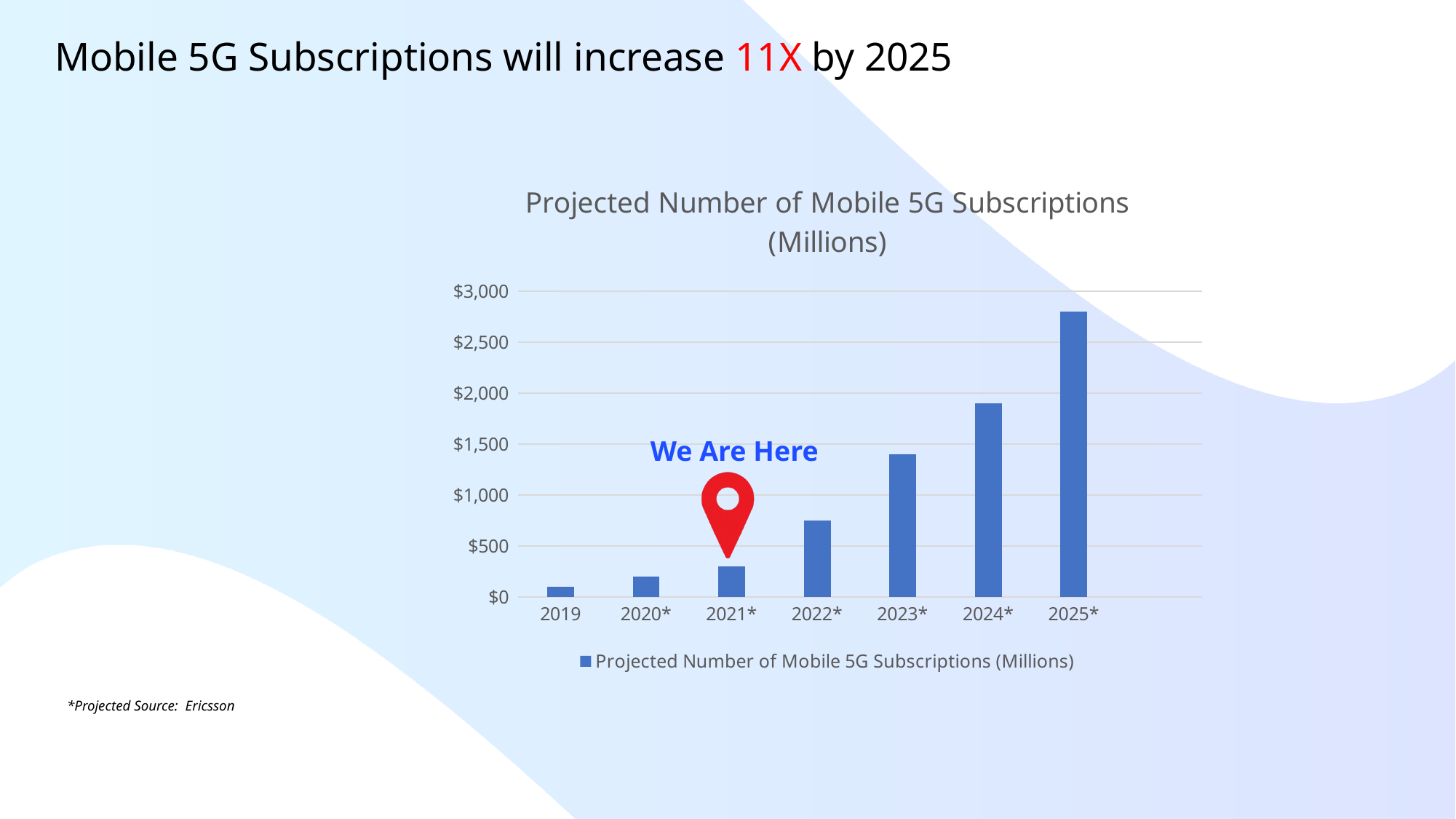
Which year does the red 'We Are Here' marker point to? 2021* How many series does the legend list? 1 Do the values rise or fall from 2019 to 2025*? Rise Is the value for 2019 greater or less than $500? less Is the value for 2025* greater or less than $2,500? greater What kind of chart is shown on the slide? Bar chart Which year has the lowest number of mobile 5G subscriptions? 2019 Is the value for 2022* greater or less than $500? greater Which year has the highest projected number of mobile 5G subscriptions? 2025* Which is larger, the value for 2023* or the value for 2022*? 2023* What is the title of the chart? Projected Number of Mobile 5G Subscriptions (Millions) How many years are shown on the x axis of the chart? 7